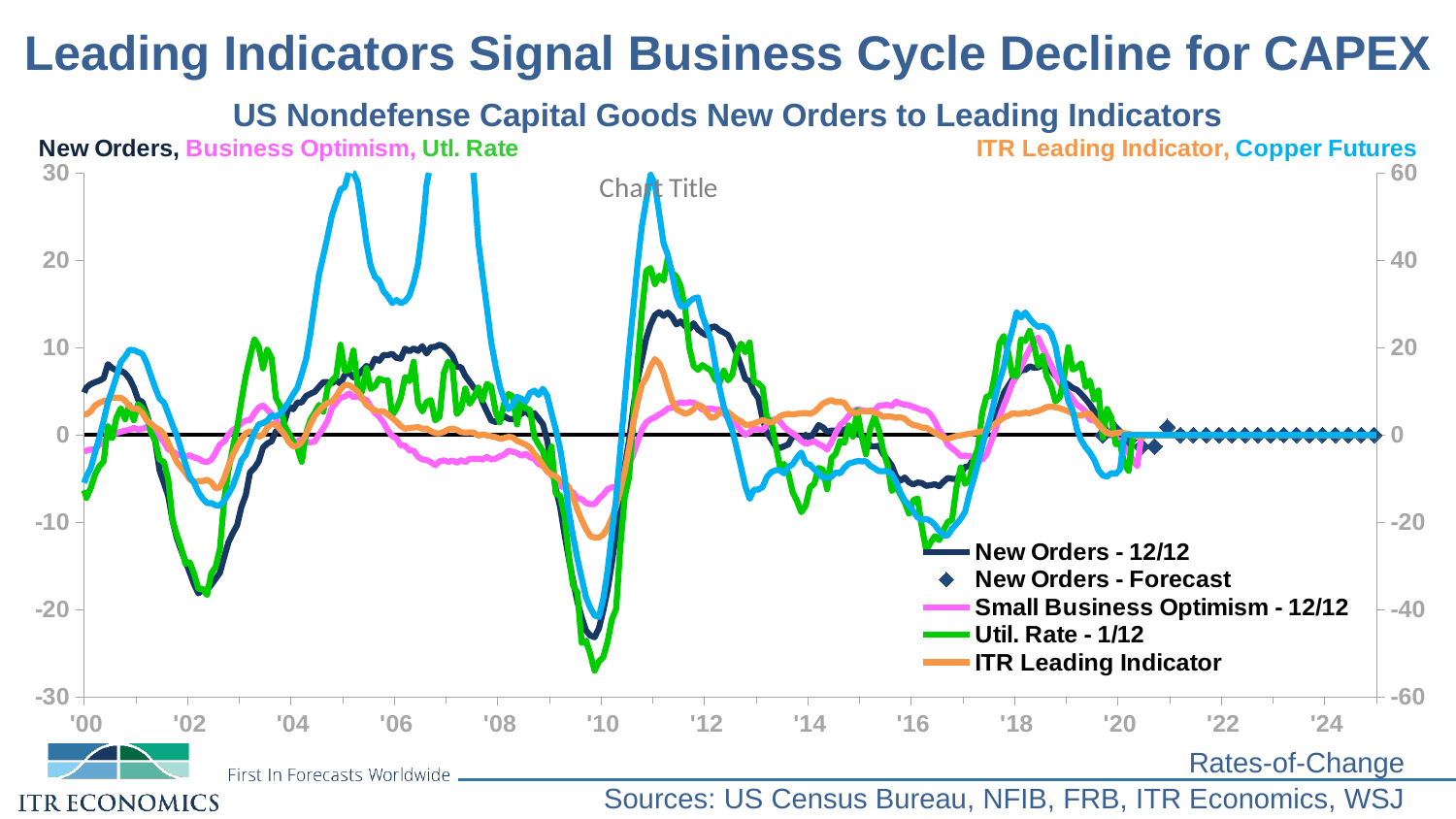
Is the lowest value of the New Orders - 12/12 line, around 2009-2010, greater or less than -20 on the left axis? less What kind of chart is shown on the slide? line chart Is the lowest value of the ITR Leading Indicator line, around 2009-2010, greater or less than -20 on the left axis? greater Is the peak of the New Orders - 12/12 line around 2011 greater or less than 10 on the left axis? greater What is the subtitle of the chart above the plot area? US Nondefense Capital Goods New Orders to Leading Indicators How many series does the chart's legend list? 5 Which series is plotted as diamond markers rather than a line? New Orders - Forecast Does the New Orders - 12/12 line rise or fall between 2018 and 2020? fall What is the maximum value shown on the right-hand vertical axis? 60 Which series reaches the lowest point on the chart around 2009-2010? Util. Rate - 1/12